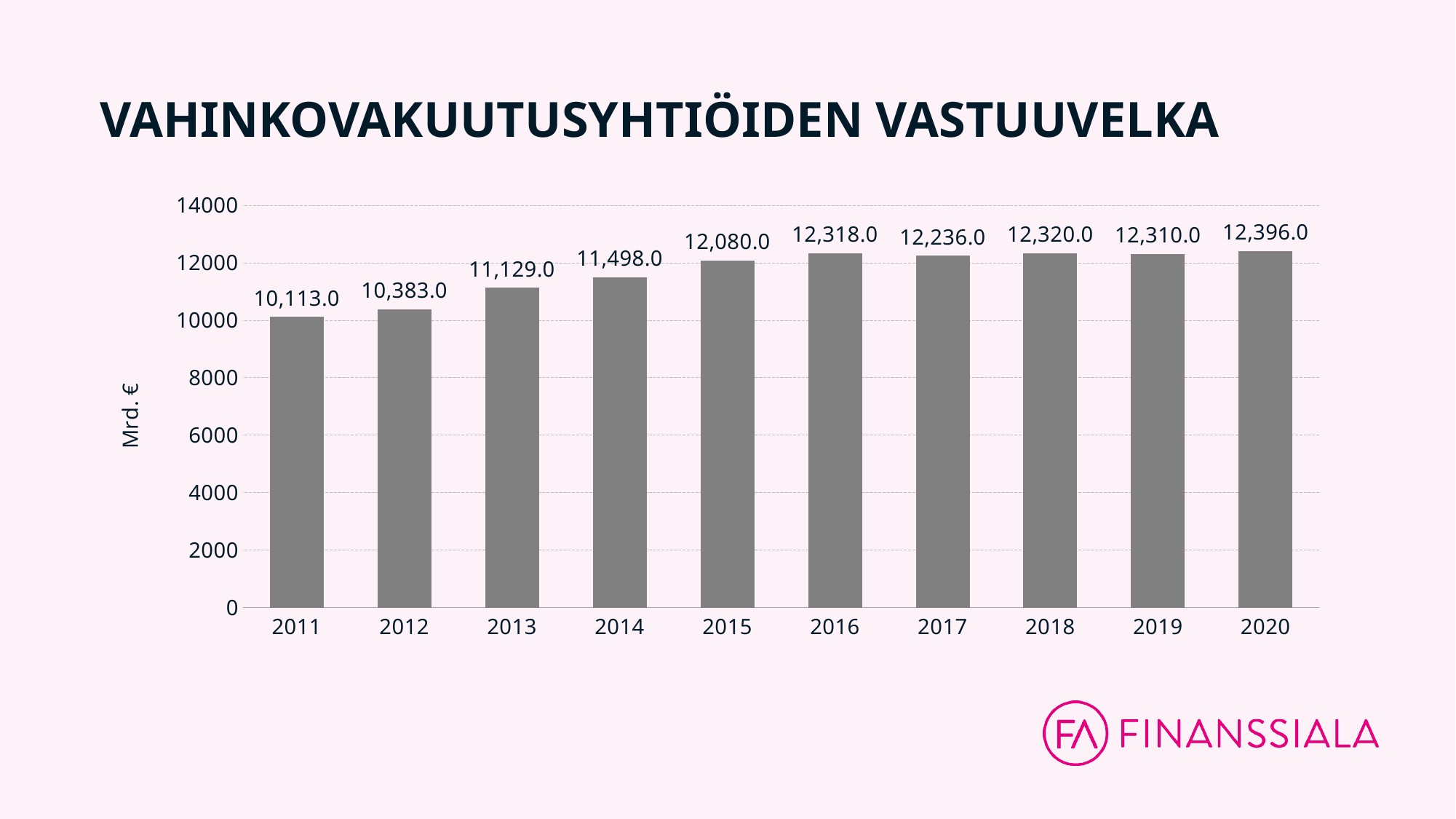
How many years are shown on the x axis? 10 Which year has the lowest value? 2011 What is the value for 2016? 12,318.0 What is the unit shown on the y axis label? Mrd. € What kind of chart is shown on the slide? bar chart What is the difference between the values for 2014 and 2013? 369.0 Is the value for 2013 greater or less than 12000? less What is the value for 2020? 12,396.0 Which is larger, the value for 2016 or the value for 2017? 2016 Which year has the highest value? 2020 What is the difference between the values for 2020 and 2011? 2,283.0 What is the value for 2011? 10,113.0